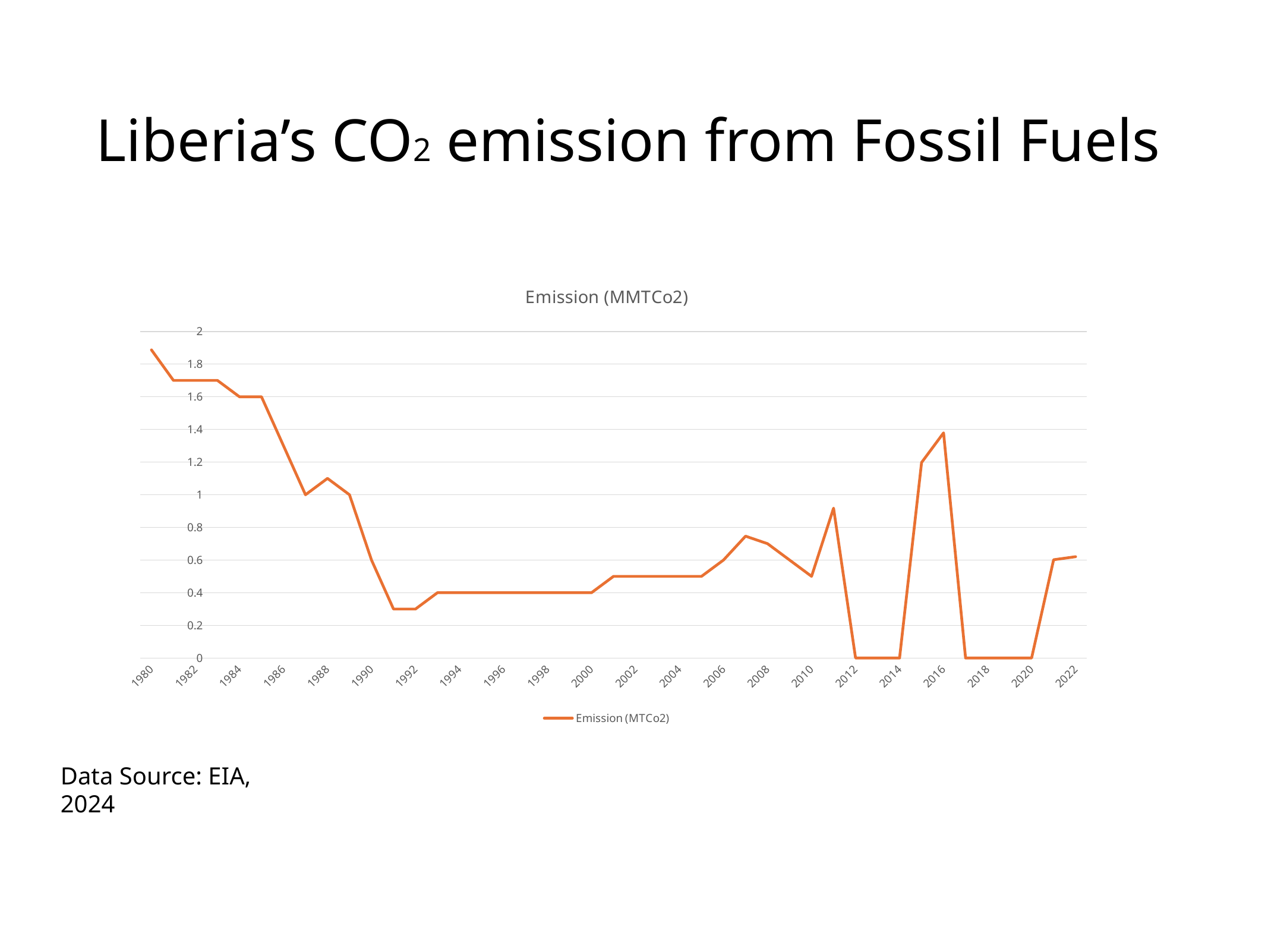
Do emission values rise or fall from 1980 to 1992? fall Is the emission value for 2016 greater or less than 1.2? greater What is the emission value for 2012? 0 What is the emission value for 1984? 1.6 What is the title shown above the chart? Emission (MMTCo2) Which year has the highest emission value? 1980 What colour is the plotted line? orange What is the emission value for 1998? 0.4 What kind of chart is shown on the slide? line chart How many series does the legend list? 1 Is the emission value for 1980 greater or less than 1.8? greater What is the emission value for 2018? 0